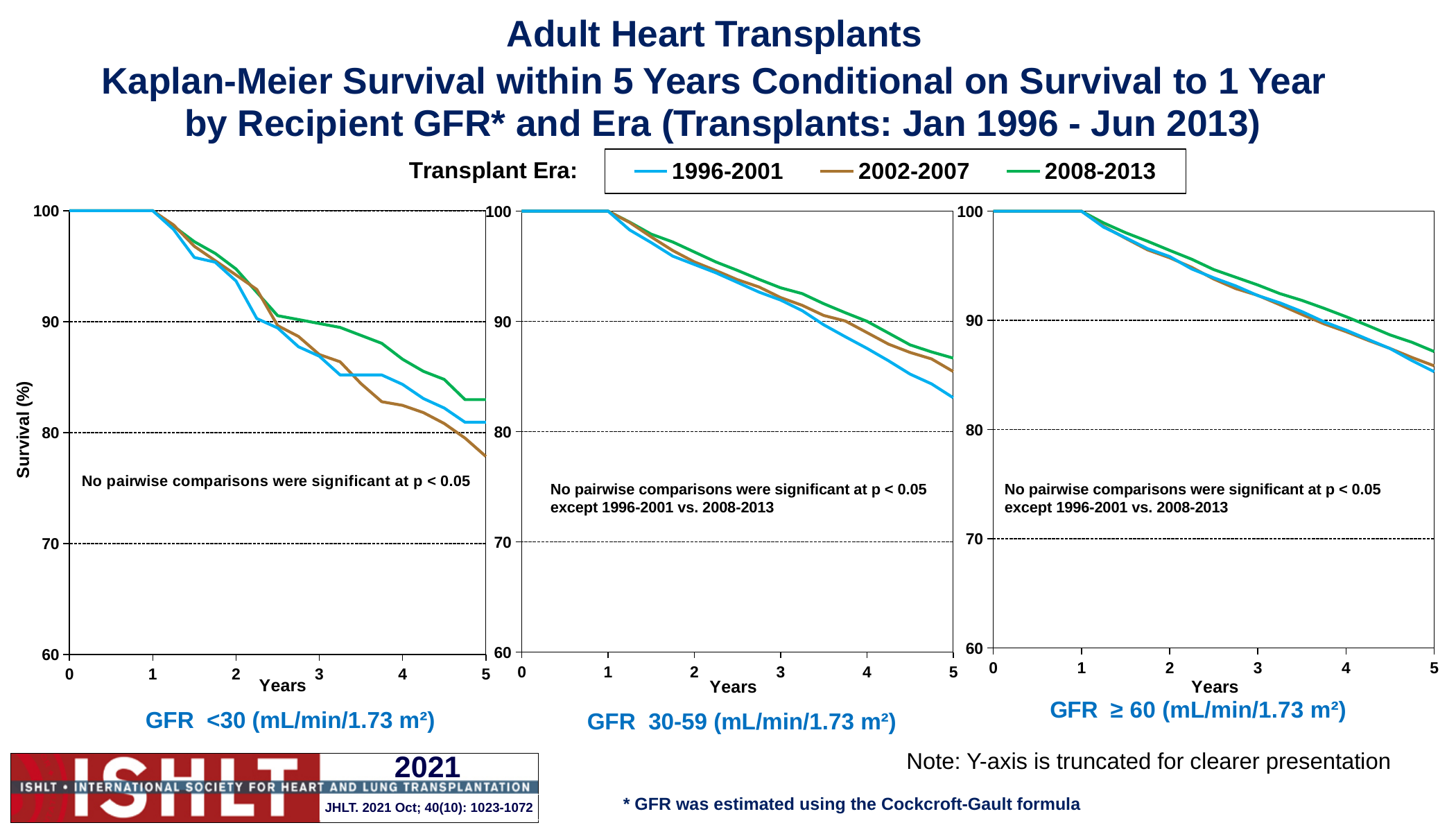
In the GFR <30 (mL/min/1.73 m²) chart, which era has the lowest survival at year 5? 2002-2007 In the GFR 30-59 (mL/min/1.73 m²) chart, which era has the lowest survival at year 5? 1996-2001 How many charts are shown on the slide? 3 What kind of chart is the GFR <30 (mL/min/1.73 m²) chart? line chart In the GFR 30-59 (mL/min/1.73 m²) chart, do the survival curves rise or fall from year 1 to year 5? fall In the GFR ≥ 60 (mL/min/1.73 m²) chart, which era has the highest survival at year 5? 2008-2013 What is the label on the y-axis of the charts? Survival (%) In the GFR <30 (mL/min/1.73 m²) chart, is the survival value for 2008-2013 at year 5 greater or less than 80? greater In the GFR <30 (mL/min/1.73 m²) chart, is the survival value for 2002-2007 at year 5 greater or less than 80? less In the GFR 30-59 (mL/min/1.73 m²) chart, is the survival value for 1996-2001 at year 5 greater or less than 90? less How many transplant eras does the legend list? 3